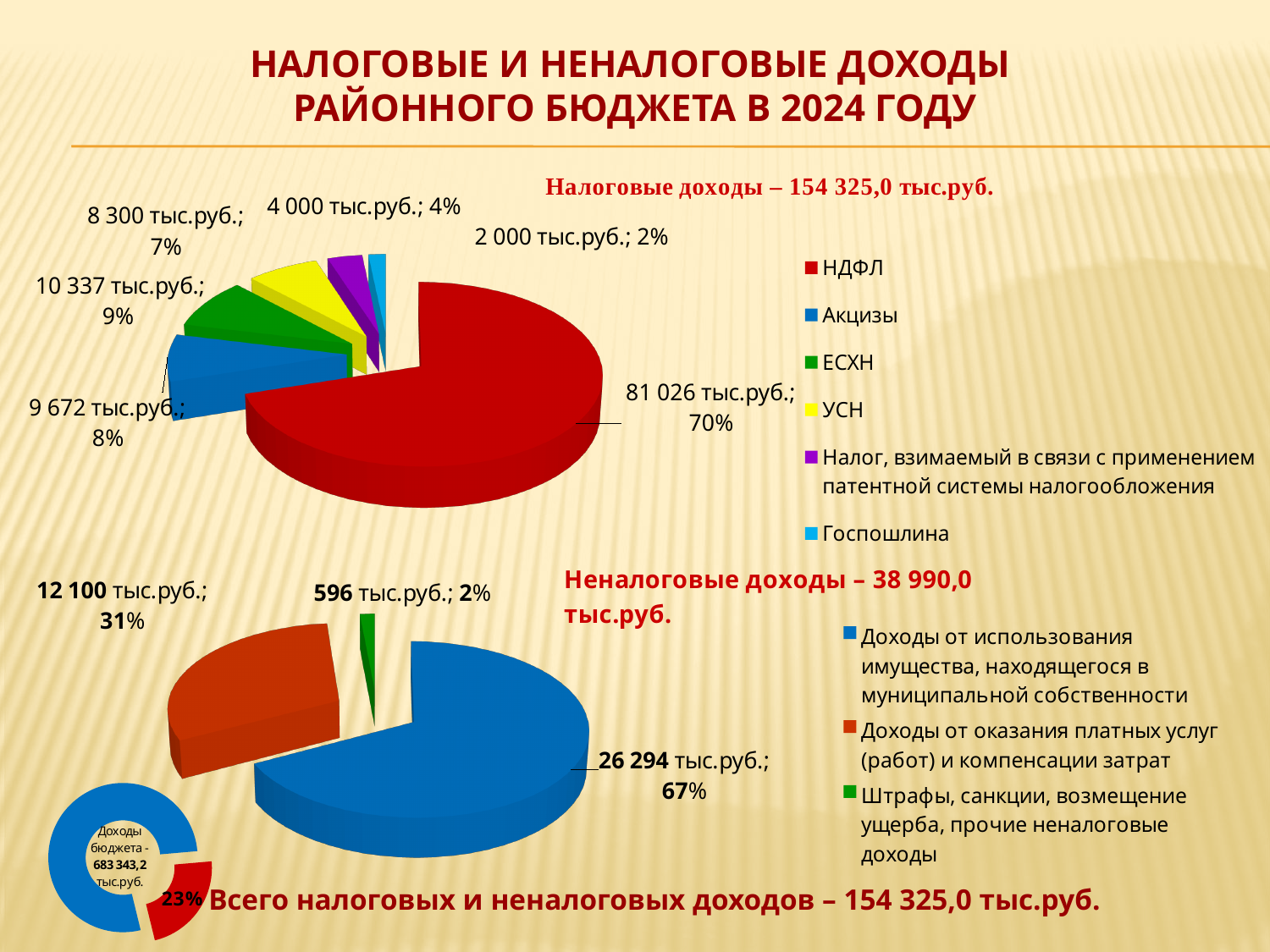
In the top pie chart (Налоговые доходы), what is the value for НДФЛ? 81 026 тыс.руб. In the top pie chart (Налоговые доходы), what is the value for ЕСХН? 10 337 тыс.руб. In the top pie chart (Налоговые доходы), what share of the pie does НДФЛ take? 70% In the top pie chart (Налоговые доходы), which is larger: Акцизы or ЕСХН? ЕСХН How many categories does the legend of the top pie chart (Налоговые доходы) list? 6 In the bottom pie chart (Неналоговые доходы), what share of the pie does Доходы от оказания платных услуг (работ) и компенсации затрат take? 31% In the top pie chart (Налоговые доходы), which category has the smallest value? Госпошлина In the top pie chart (Налоговые доходы), what is the difference between the УСН value and the Госпошлина value? 6 300 тыс.руб. In the bottom pie chart (Неналоговые доходы), what is the value for Доходы от использования имущества, находящегося в муниципальной собственности? 26 294 тыс.руб. In the top pie chart (Налоговые доходы), what colour is the НДФЛ slice? Red What type of chart is the bottom chart (Неналоговые доходы)? Pie chart In the bottom pie chart (Неналоговые доходы), which category has the largest value? Доходы от использования имущества, находящегося в муниципальной собственности